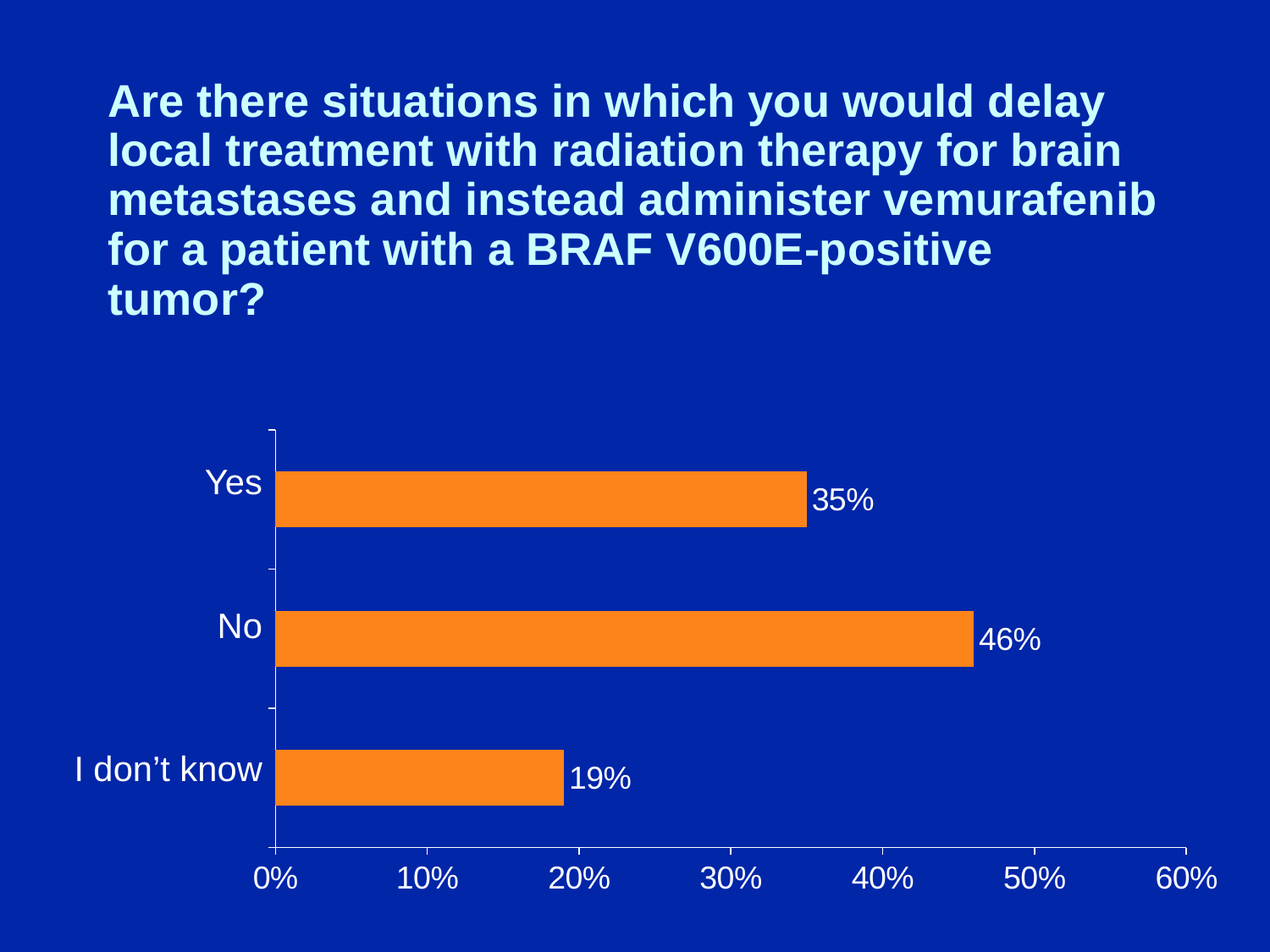
What is the difference in percentage points between the "No" and "Yes" responses? 11 Which response has the highest percentage? No Which response has the lowest percentage? I don't know What is the maximum value shown on the horizontal axis? 60% What kind of chart is shown on the slide? Bar chart How many response categories are shown in the chart? 3 What percentage of respondents answered "No"? 46% What percentage of respondents answered "I don't know"? 19% Which is larger, the percentage for "Yes" or for "I don't know"? Yes Is the value for "No" greater or less than 40%? greater What is the difference in percentage points between the "Yes" and "I don't know" responses? 16 What percentage of respondents answered "Yes"? 35%